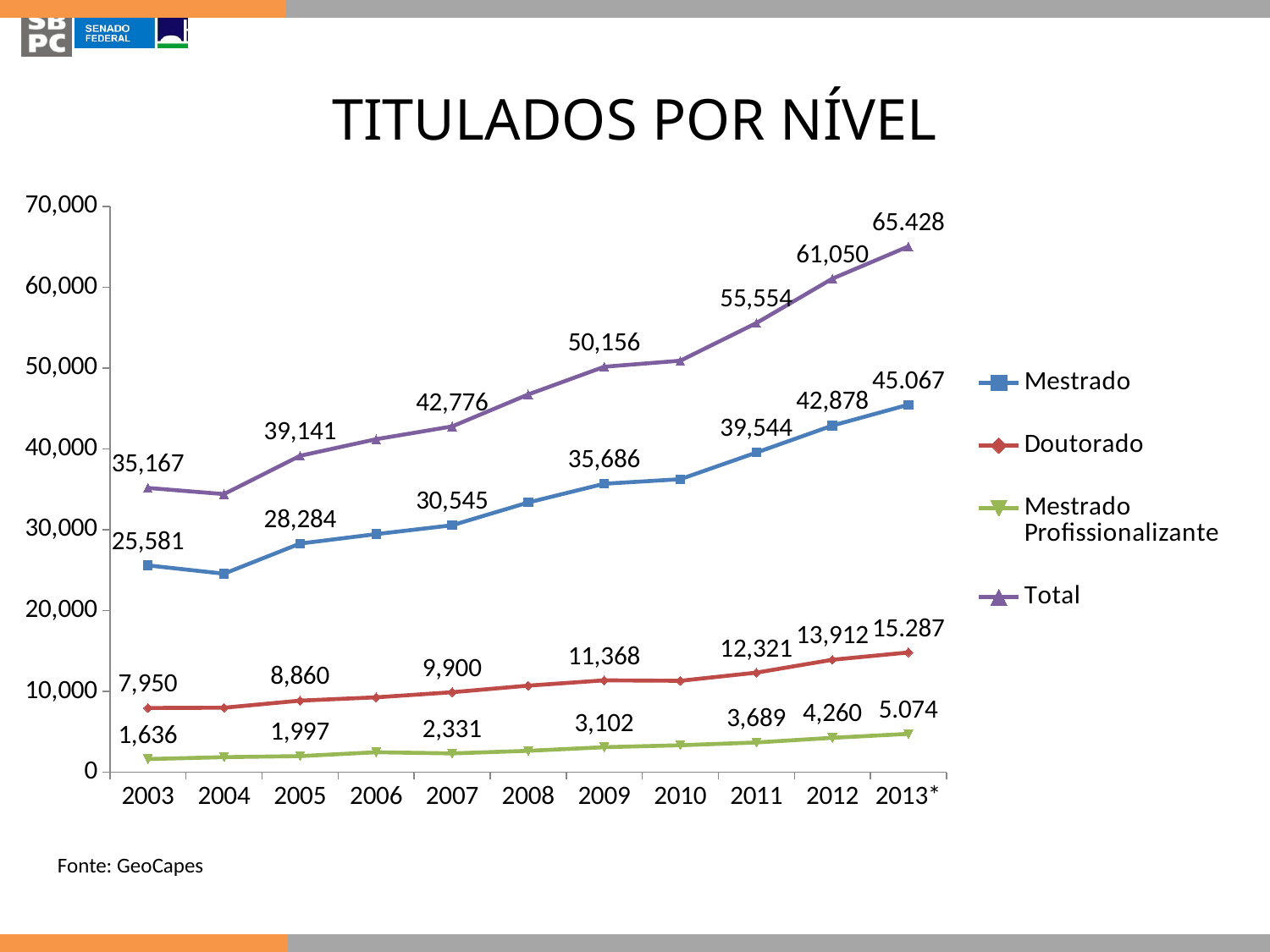
Which series has the lowest values across all years? Mestrado Profissionalizante Is the value for Total in 2008 greater or less than 50,000? less What is the value for Mestrado in 2011? 39,544 What is the difference between the Mestrado values for 2009 and 2007? 5,141 What is the difference between the Total values for 2012 and 2011? 5,496 What is the value for Doutorado in 2007? 9,900 What is the value for Mestrado Profissionalizante in 2013*? 5.074 Is the value for Mestrado in 2004 greater or less than 30,000? less How many series does the legend list? 4 Which is larger, the Doutorado value in 2012 or the Mestrado Profissionalizante value in 2012? Doutorado How many years are shown on the x axis? 11 What is the value for Total in 2009? 50,156